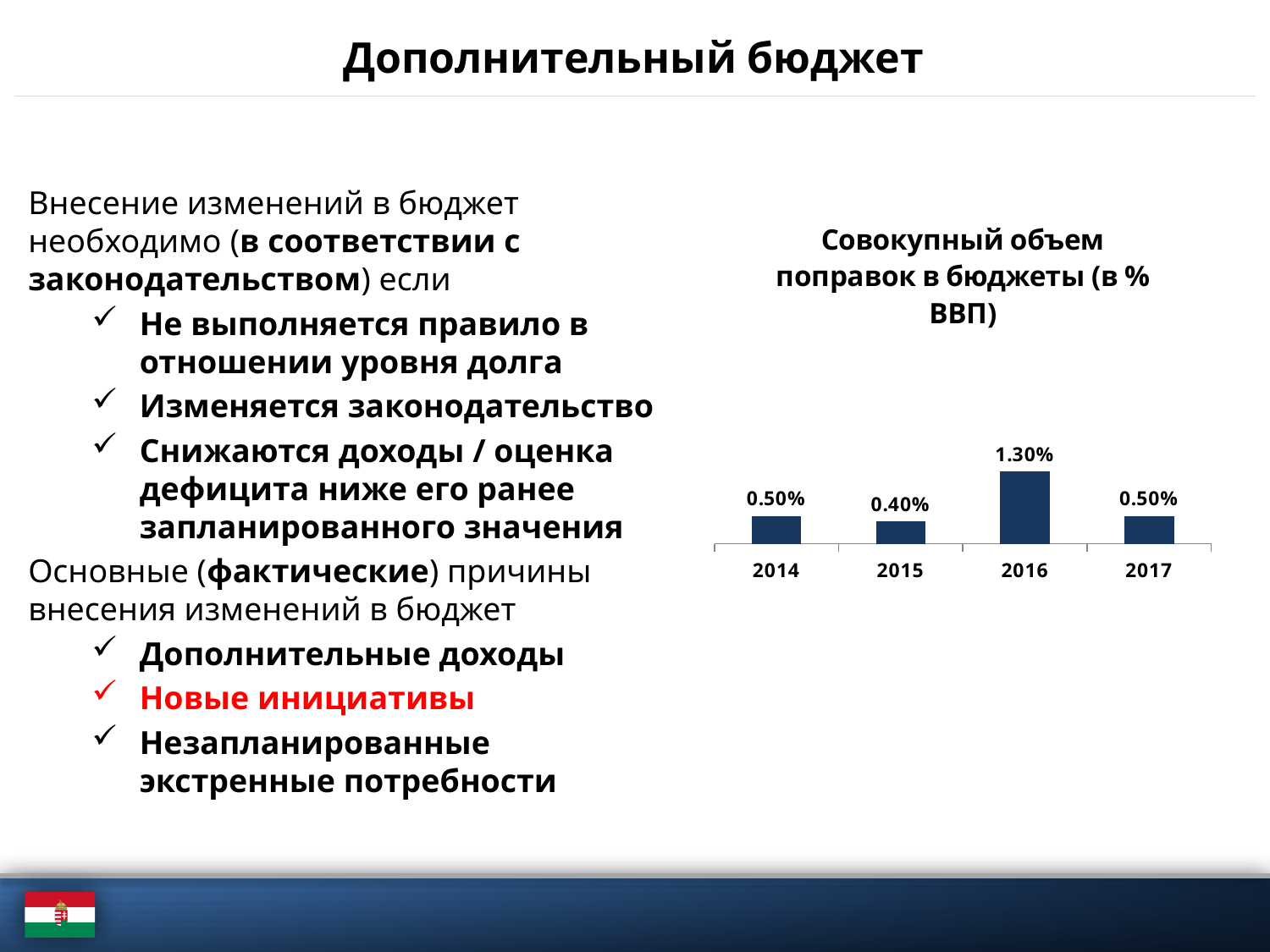
Which is larger, the value for 2016 or the value for 2017? 2016 What is the value for 2014? 0.50% What is the difference between the values for 2016 and 2015? 0.90% Which year has the lowest value? 2015 What is the title of the chart? Совокупный объем поправок в бюджеты (в % ВВП) How many years are shown on the chart? 4 Which year has the highest value? 2016 What is the value for 2016? 1.30% Does the value rise or fall from 2016 to 2017? Fall What kind of chart is shown on the slide? Bar chart What is the value for 2015? 0.40% What is the value for 2017? 0.50%